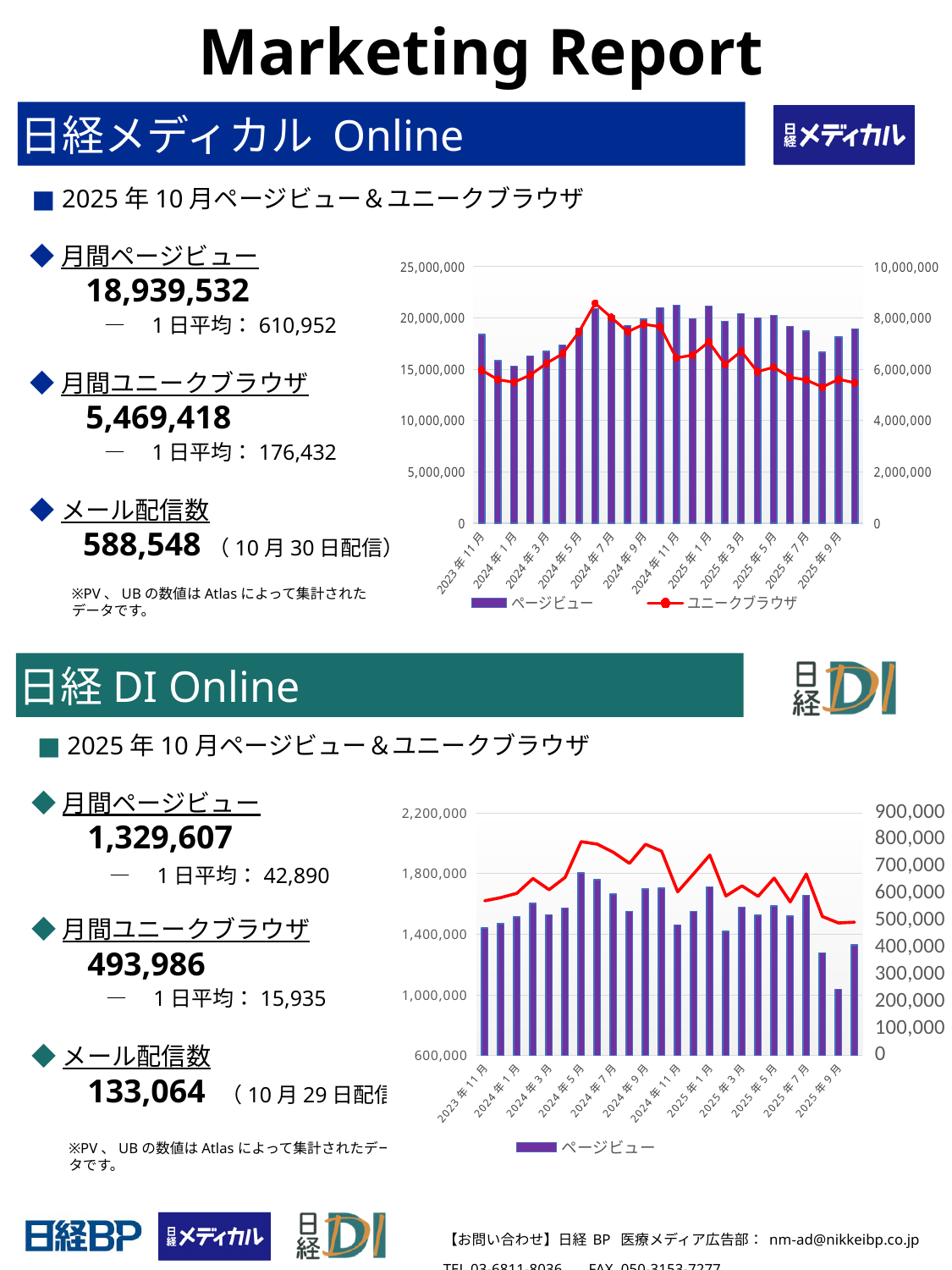
In the 日経 DI Online chart, which labelled month has the highest ページビュー bar? 2024年5月 What kind of chart is the 日経メディカル Online chart? Combined bar and line chart In the 日経 DI Online chart, how many entries does the legend list? 1 In the 日経メディカル Online chart, what are the two legend entries? ページビュー and ユニークブラウザ In the 日経 DI Online chart, which labelled month has the lowest ページビュー bar? 2025年9月 In the 日経メディカル Online chart, is the ページビュー bar for 2024年1月 greater or less than 20,000,000? less In the 日経メディカル Online chart, does the ユニークブラウザ line generally rise or fall from 2024年7月 to the end of the period? fall In the 日経 DI Online chart, is the ページビュー bar for 2025年9月 greater or less than 1,400,000? less In the 日経メディカル Online chart, which is larger, the ページビュー bar for 2024年7月 or for 2024年1月? 2024年7月 In the 日経メディカル Online chart, how many series does the legend list? 2